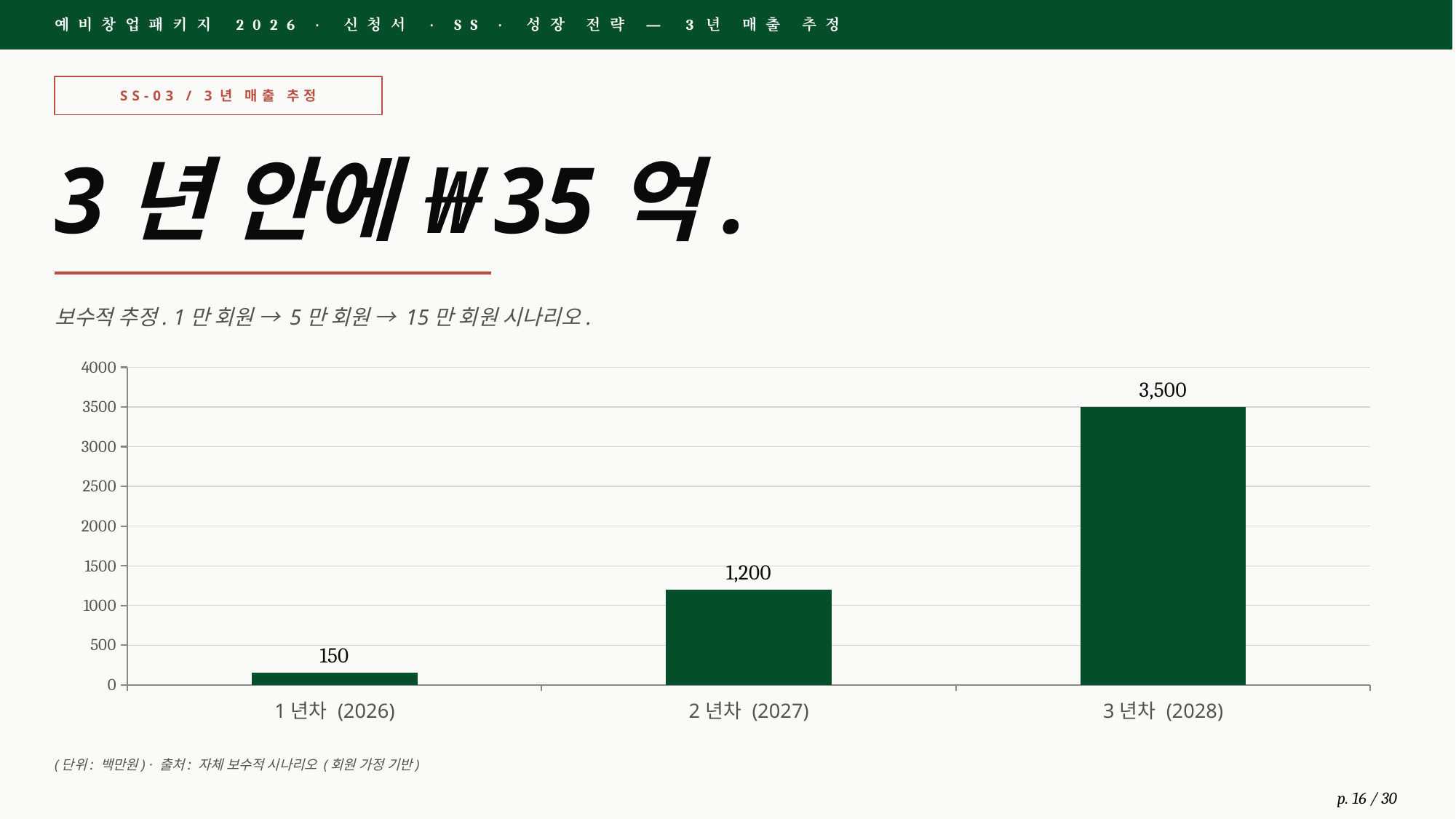
Which year has the lowest value? 1 년차 (2026) Which is larger, the value for 2 년차 (2027) or 1 년차 (2026)? 2 년차 (2027) Do the values rise or fall from 1 년차 (2026) to 3 년차 (2028)? rise What is the value for 3 년차 (2028)? 3,500 What kind of chart is shown on the slide? bar chart How many categories are shown on the x axis? 3 What is the value for 1 년차 (2026)? 150 What is the difference between the values for 2 년차 (2027) and 1 년차 (2026)? 1,050 Which year has the highest value? 3 년차 (2028) What is the value for 2 년차 (2027)? 1,200 What is the difference between the values for 3 년차 (2028) and 2 년차 (2027)? 2,300 Is the value for 2 년차 (2027) greater or less than 1000? greater